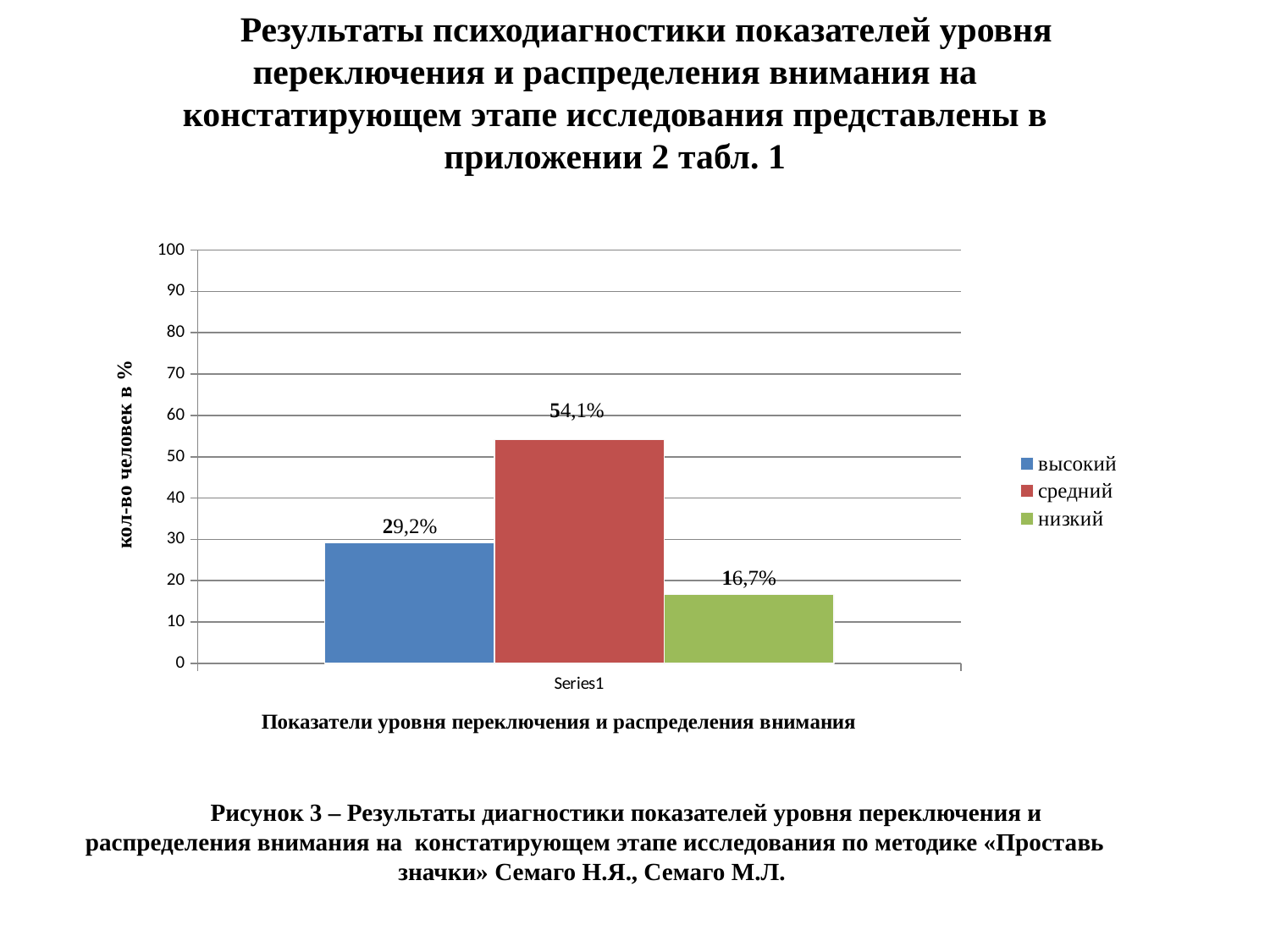
What kind of chart is shown on the slide? bar chart What is the difference between the 'высокий' and 'низкий' values? 12,5% Is the value for 'средний' greater or less than 50? greater Which series has the lowest value? низкий What is the value for the 'высокий' series? 29,2% What is the value for the 'средний' series? 54,1% What is the difference between the 'средний' and 'высокий' values? 24,9% How many series does the legend list? 3 What is the label of the y axis? кол-во человек в % Which is larger, the value for 'высокий' or the value for 'низкий'? высокий What is the value for the 'низкий' series? 16,7% Which series has the highest value? средний